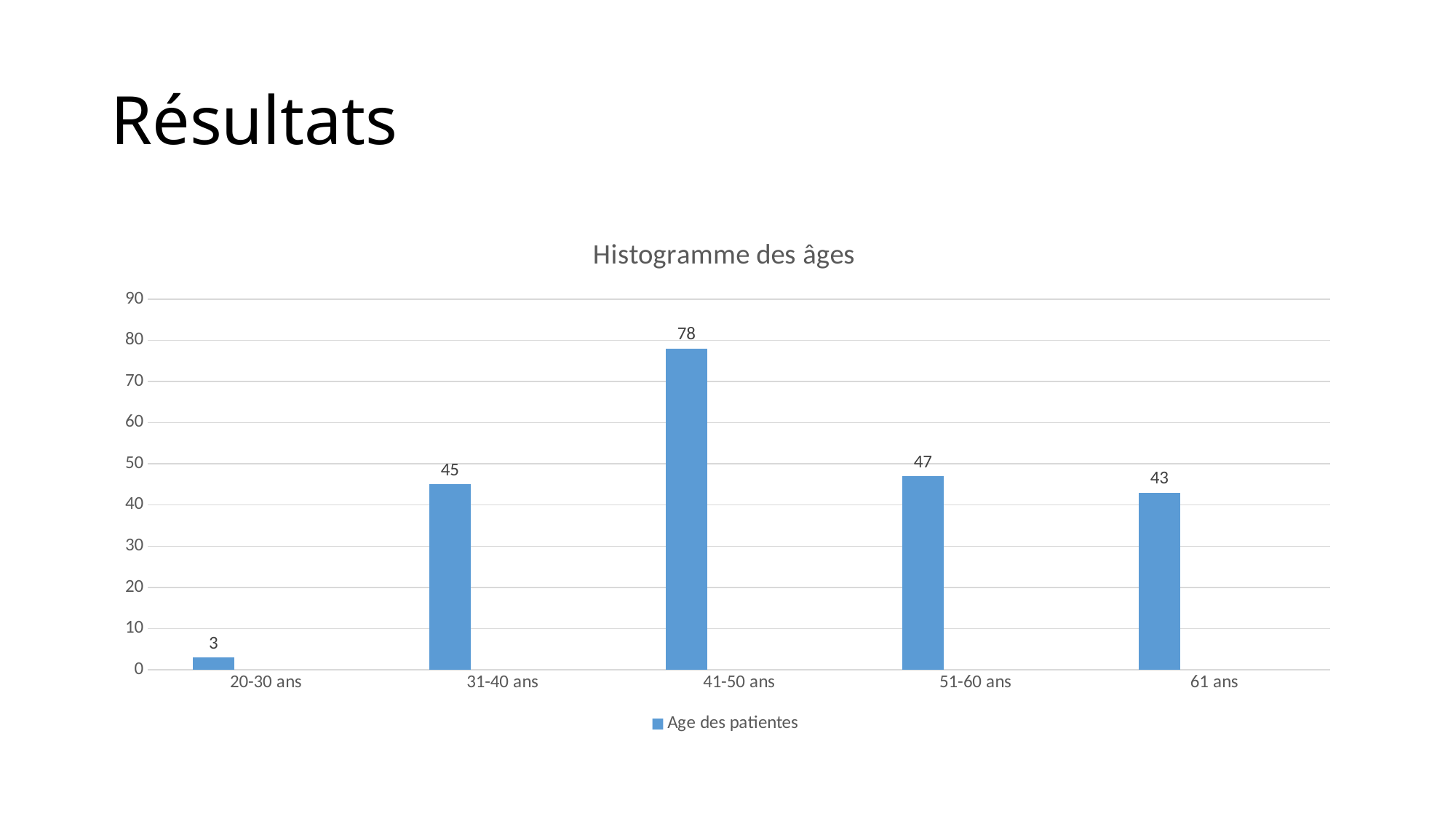
Is the value for 31-40 ans greater or less than 50? less What is the value for the 41-50 ans category? 78 How many age categories are shown on the x axis? 5 Which age category has the highest value? 41-50 ans What is the title of the chart? Histogramme des âges Which age category has the lowest value? 20-30 ans What is the value for the 20-30 ans category? 3 Which is larger, the value for 51-60 ans or the value for 61 ans? 51-60 ans What kind of chart is shown on the slide? bar chart What is the value for the 61 ans category? 43 What is the difference between the values for 41-50 ans and 31-40 ans? 33 How many series does the legend list? 1